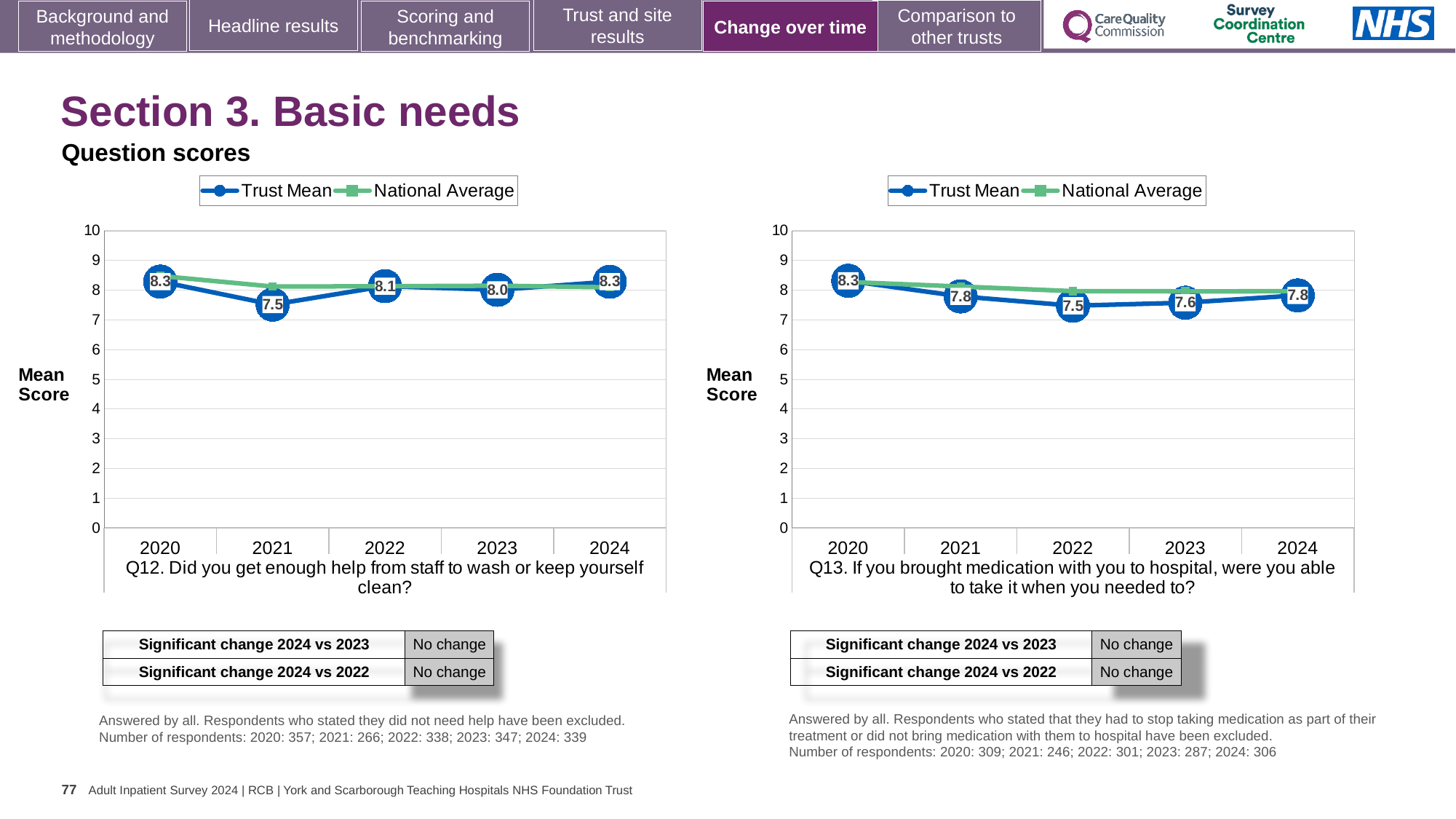
What type of chart is the Q12 chart (left)? Line chart On the Q13 chart (right), which year has the highest Trust Mean score? 2020 On the Q13 chart (right), is the Trust Mean score for 2021 or 2022 larger? 2021 On the Q13 chart (right), what is the difference between the Trust Mean scores for 2020 and 2022? 0.8 On the Q13 chart (right), what is the Trust Mean score for 2020? 8.3 On the Q12 chart (left), what is the Trust Mean score for 2024? 8.3 How many years are plotted on the Q12 chart (left)? 5 On the Q12 chart (left), what is the difference between the Trust Mean scores for 2020 and 2021? 0.8 How many series does the legend of the Q13 chart (right) list? 2 On the Q12 chart (left), what is the Trust Mean score for 2021? 7.5 On the Q13 chart (right), what is the Trust Mean score for 2022? 7.5 On the Q12 chart (left), which year has the lowest Trust Mean score? 2021